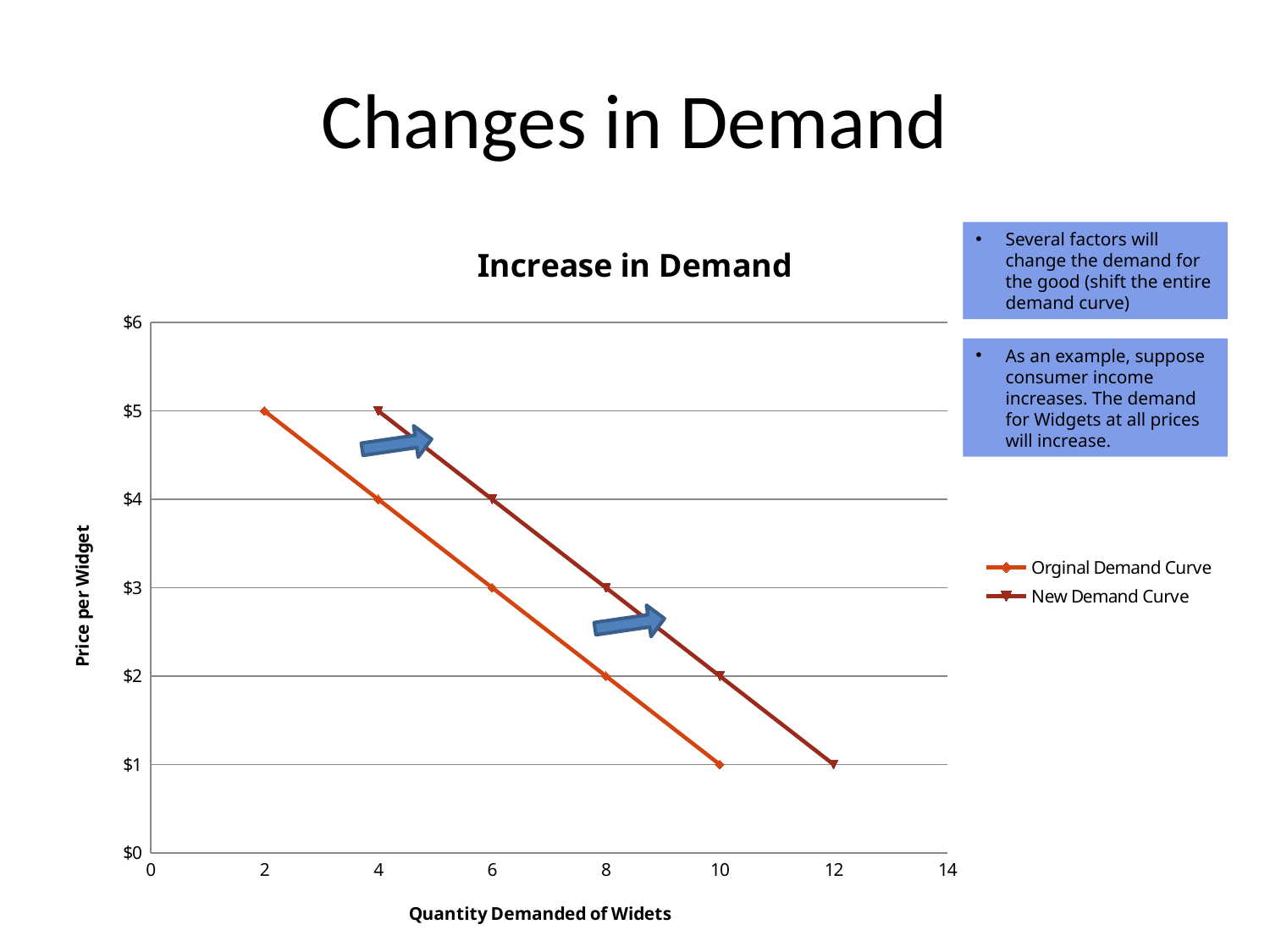
How many data points are plotted on the Orginal Demand Curve? 5 On the Orginal Demand Curve, what quantity is demanded at a price of $5? 2 How many series does the legend list? 2 What kind of chart is shown? line chart At a price of $3, how much larger is the quantity demanded on the New Demand Curve than on the Orginal Demand Curve? 2 On the New Demand Curve, what quantity is demanded at a price of $5? 4 What is the title of the chart? Increase in Demand At a price of $2, which series shows the larger quantity demanded? New Demand Curve What is the label of the x axis? Quantity Demanded of Widets On the Orginal Demand Curve, what quantity is demanded at a price of $1? 10 On the New Demand Curve, what quantity is demanded at a price of $1? 12 As quantity demanded increases along the x axis, does the price on each curve rise or fall? fall